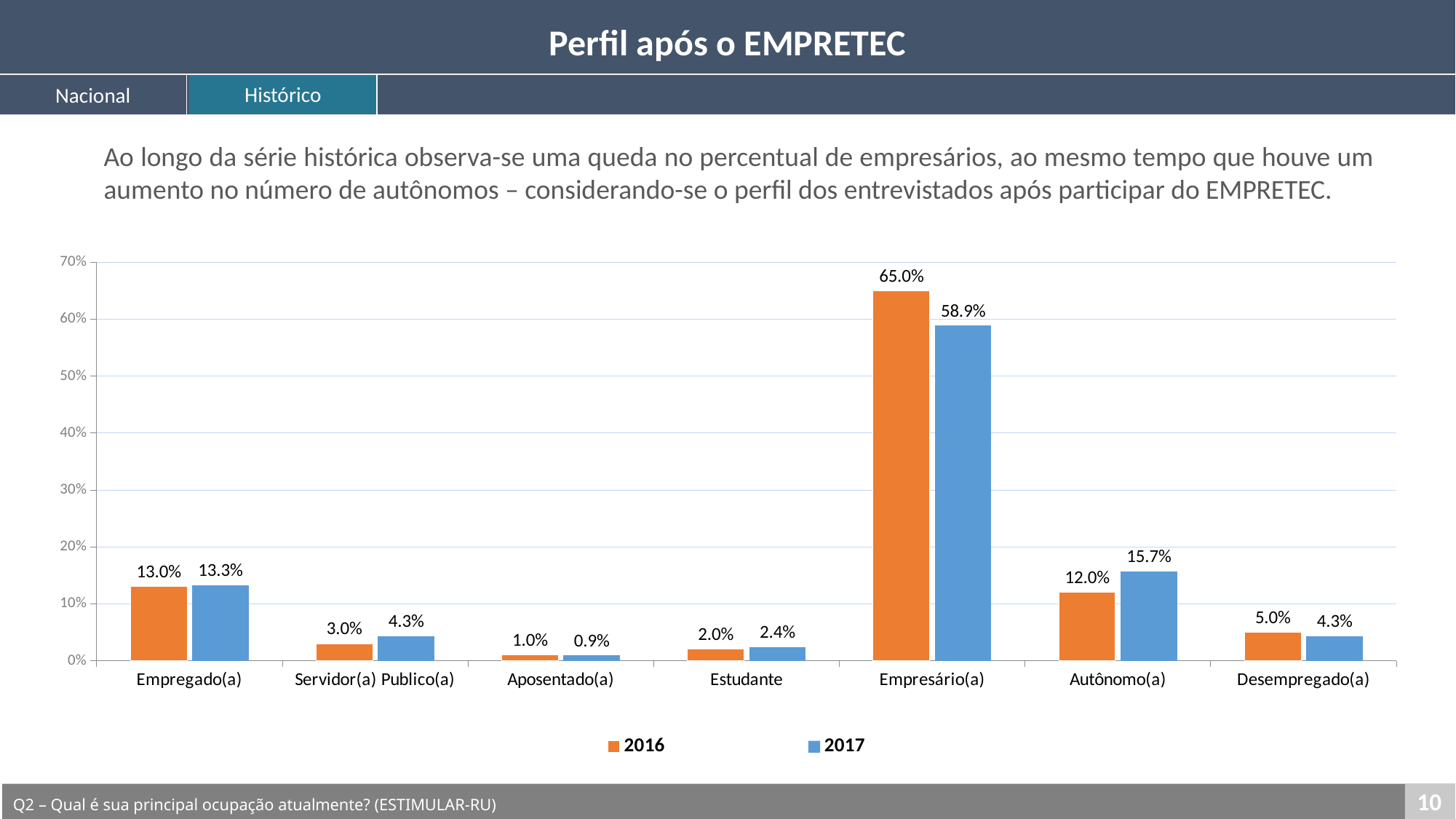
What kind of chart is shown on the slide? Bar chart Which is larger for Desempregado(a): the 2016 value or the 2017 value? 2016 Which category has the lowest value in 2016? Aposentado(a) Is the value for Empresário(a) in 2017 greater or less than 50%? greater How many series does the legend list? 2 What is the difference between the 2017 and 2016 values for Autônomo(a)? 3.7% Which category has the highest value in 2017? Empresário(a) How many categories are shown on the x axis? 7 What is the difference between the 2016 and 2017 values for Empresário(a)? 6.1% What is the value for Empresário(a) in 2016? 65.0% What is the value for Autônomo(a) in 2017? 15.7% What is the value for Aposentado(a) in 2017? 0.9%